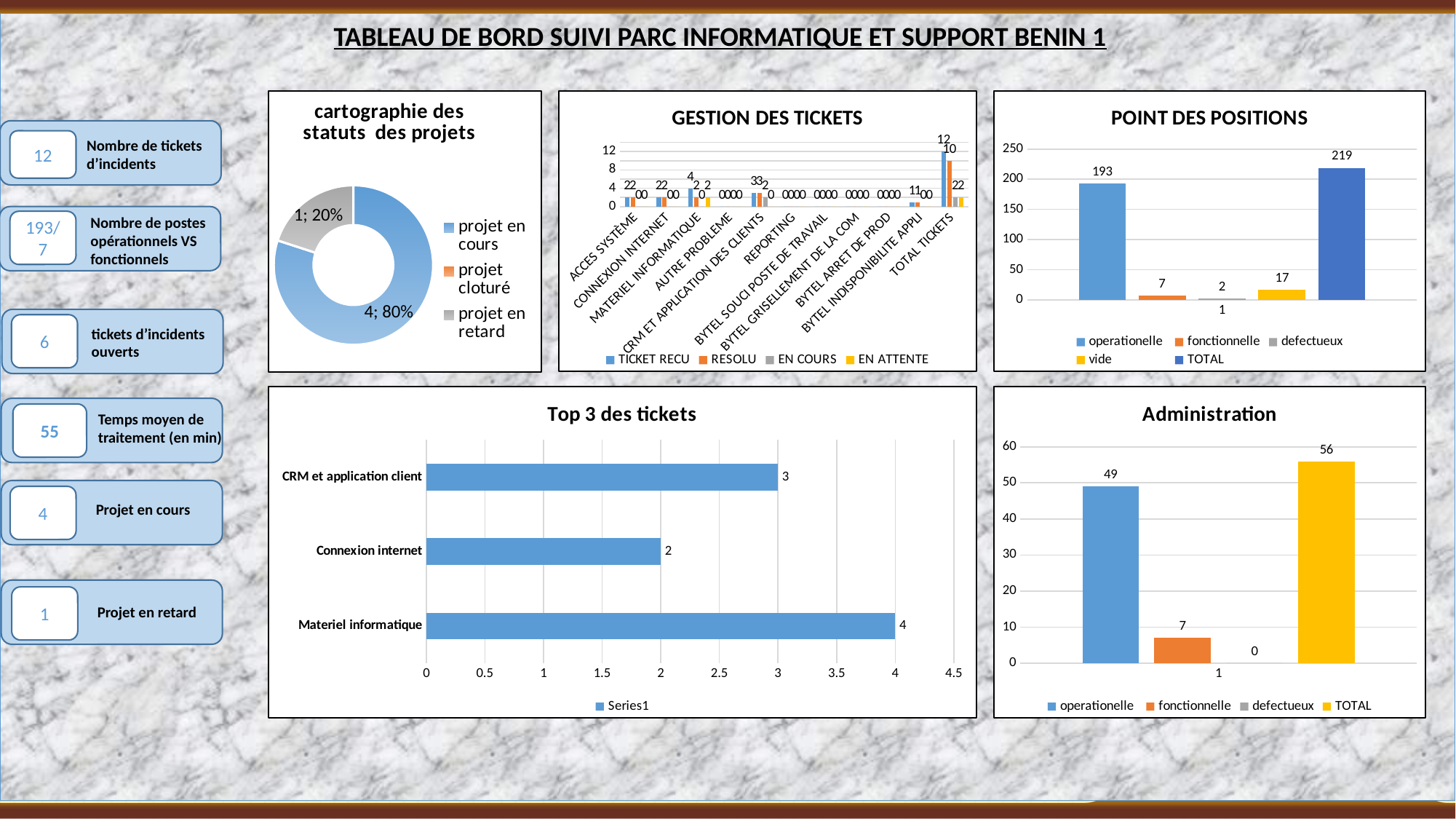
In the 'POINT DES POSITIONS' chart, which series has the highest value? TOTAL In the 'GESTION DES TICKETS' chart, what is the TICKET RECU value for TOTAL TICKETS? 12 In the 'Top 3 des tickets' chart, what is the value for Materiel informatique? 4 In the 'POINT DES POSITIONS' chart, what is the value for operationelle? 193 What kind of chart is 'Top 3 des tickets'? bar chart In the 'Administration' chart, what is the difference between TOTAL and operationelle? 7 In the 'Top 3 des tickets' chart, what is the difference between Materiel informatique and CRM et application client? 1 In the 'cartographie des statuts des projets' chart, what share of the doughnut is 'projet en retard'? 20% In the 'POINT DES POSITIONS' chart, what is the value for vide? 17 In the 'Administration' chart, what is the value for operationelle? 49 In the 'Top 3 des tickets' chart, which category has the lowest value? Connexion internet How many series does the legend of the 'POINT DES POSITIONS' chart list? 5